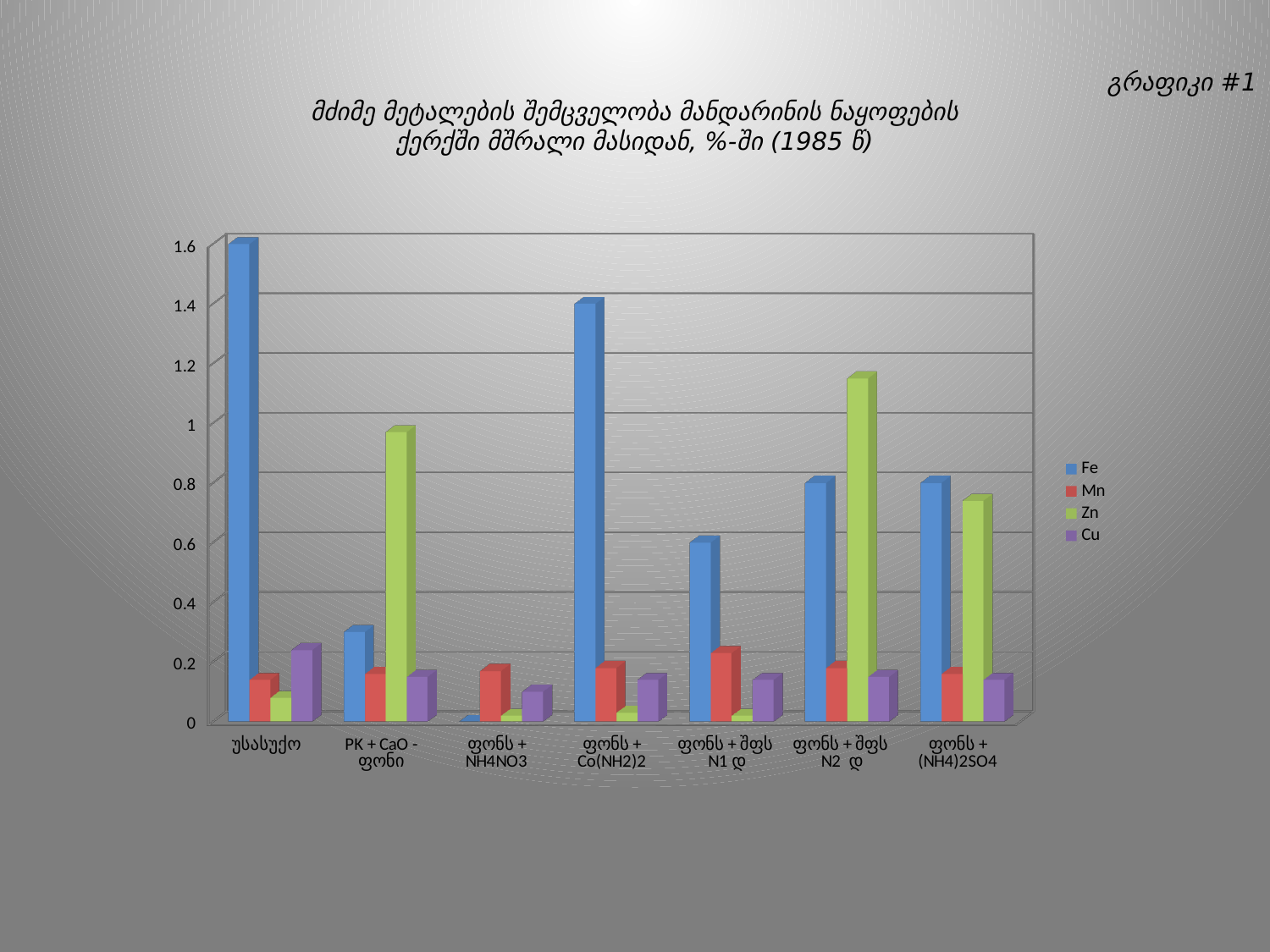
Which series are listed in the legend? Fe, Mn, Zn, Cu Which has the larger Fe value: უსასუქო or ფონს + Co(NH2)2? უსასუქო Is the Fe value for ფონს + Co(NH2)2 greater or less than 1? greater What kind of chart is shown on the slide? bar chart How many categories are shown along the x axis? 7 Which category has the highest Zn value? ფონს + შფს N2 დ Which category has the highest Fe value? უსასუქო Is the Zn value for ფონს + (NH4)2SO4 greater or less than 0.6? greater Is the Zn value for PK + CaO - ფონი greater or less than 0.8? greater How many series does the legend list? 4 Which category has the lowest Fe value? ფონს + NH4NO3